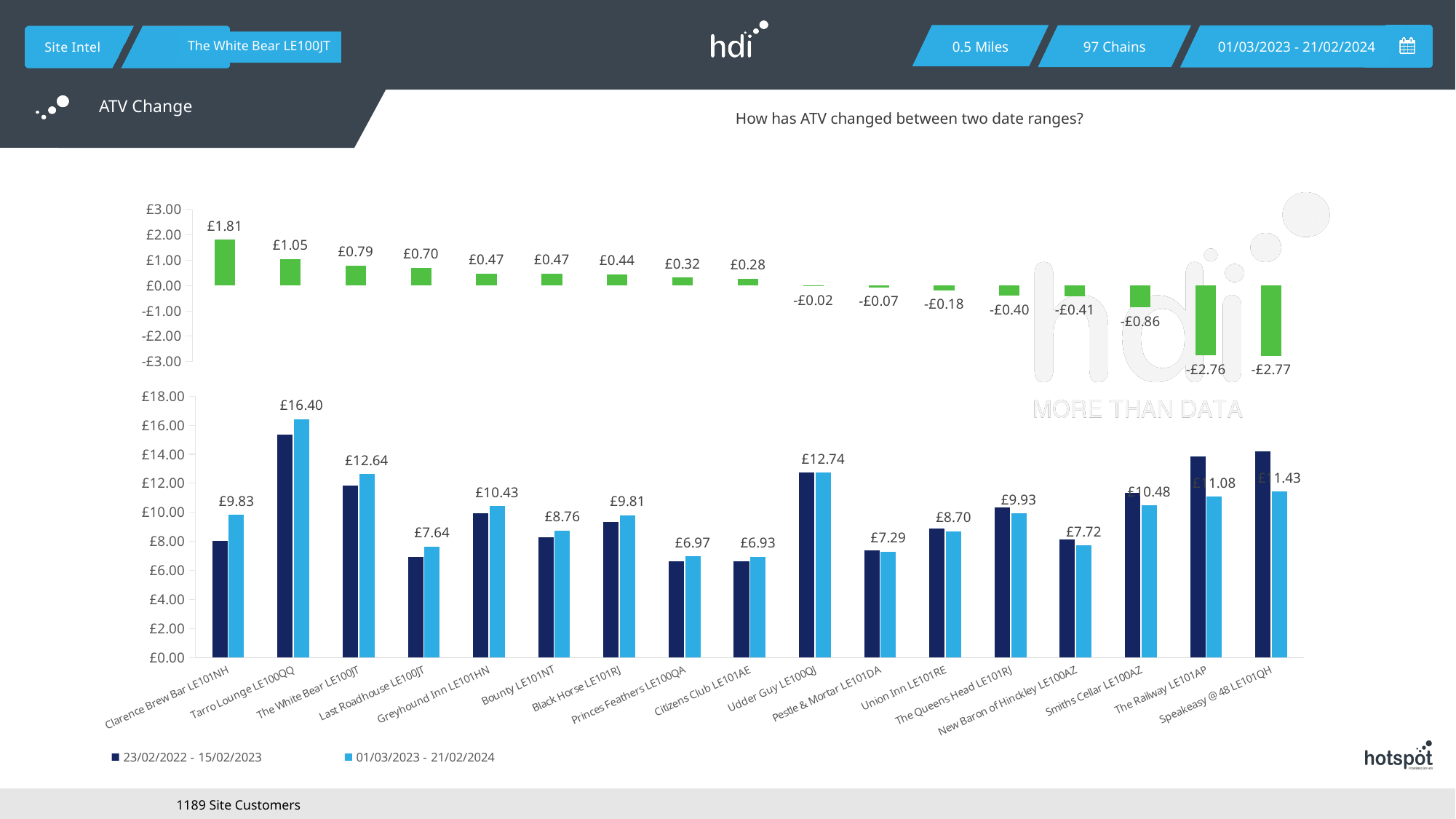
On the top chart, what is the value of the last (rightmost) bar? -£2.77 On the bottom chart, which category has the highest value in the 01/03/2023 - 21/02/2024 series? Tarro Lounge LE100QQ On the bottom chart, what is the difference between the 01/03/2023 - 21/02/2024 values for Tarro Lounge LE100QQ and The White Bear LE100JT? £3.76 On the bottom chart, what is the value for Tarro Lounge LE100QQ in the 01/03/2023 - 21/02/2024 series? £16.40 On the bottom chart, is the 23/02/2022 - 15/02/2023 value for Clarence Brew Bar LE101NH greater or less than £10.00? less On the bottom chart, which has the larger 01/03/2023 - 21/02/2024 value: Udder Guy LE100QJ or Greyhound Inn LE101HN? Udder Guy LE100QJ How many series does the legend of the bottom chart list? 2 On the bottom chart, which category has the lowest labelled value in the 01/03/2023 - 21/02/2024 series? Citizens Club LE101AE What kind of chart is the bottom chart? bar chart On the top chart, how many bars have a negative value? 8 How many categories are shown on the x axis of the bottom chart? 17 On the top chart, what is the value of the first (leftmost) bar? £1.81